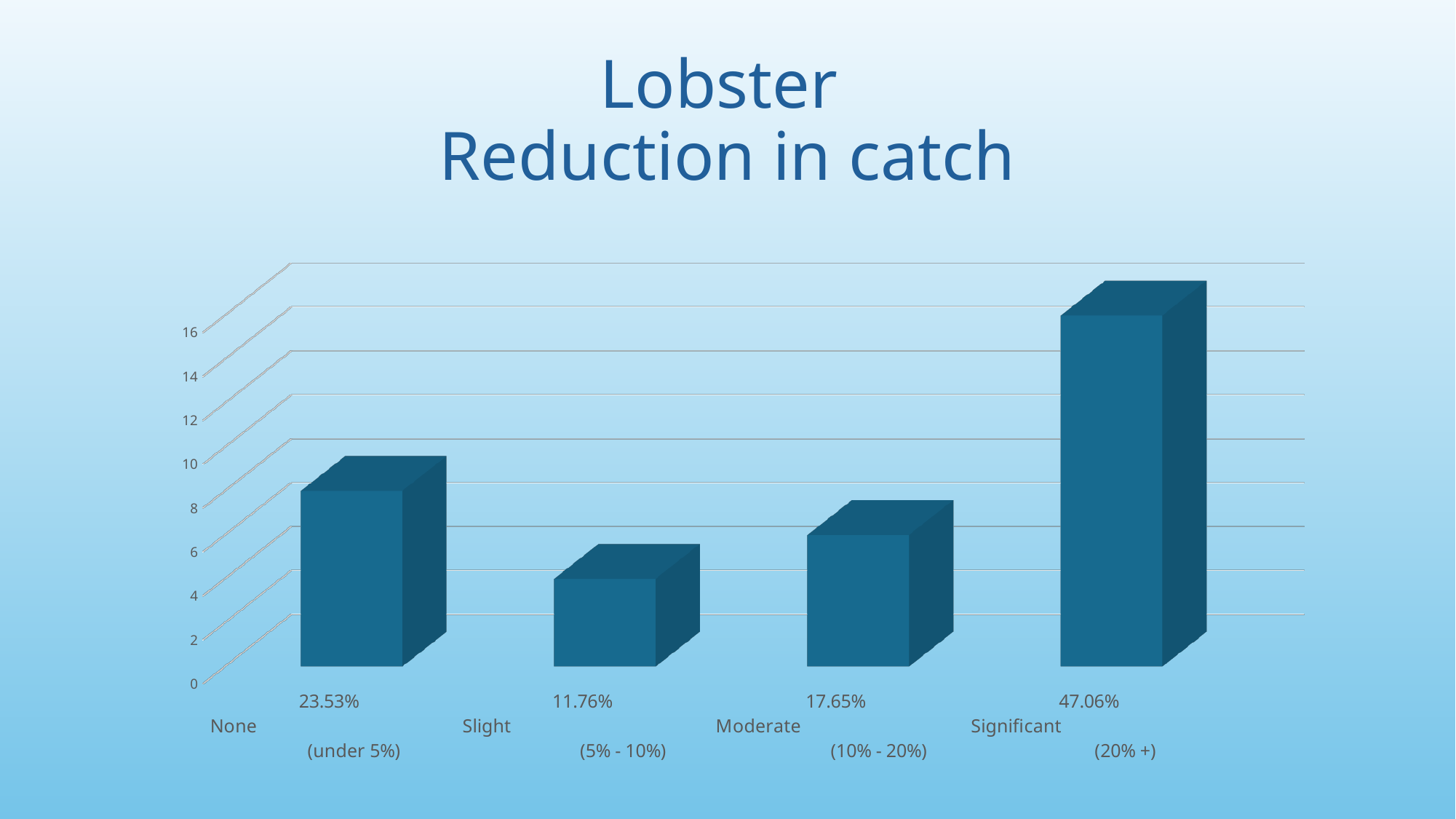
How many categories are shown on the x axis? 4 Which category has the shortest bar? Slight (5% - 10%) Is the value for Slight (5% - 10%) greater or less than 6? less Which bar is taller, None (under 5%) or Moderate (10% - 20%)? None (under 5%) What percentage is printed in the label for the Significant (20% +) category? 47.06% Which category has the tallest bar? Significant (20% +) Is the value for Significant (20% +) greater or less than 14? greater Is the value for Moderate (10% - 20%) greater or less than 8? less What is the title of the chart? Lobster Reduction in catch What kind of chart is shown on the slide? bar chart What percentage is printed in the label for the Slight (5% - 10%) category? 11.76%